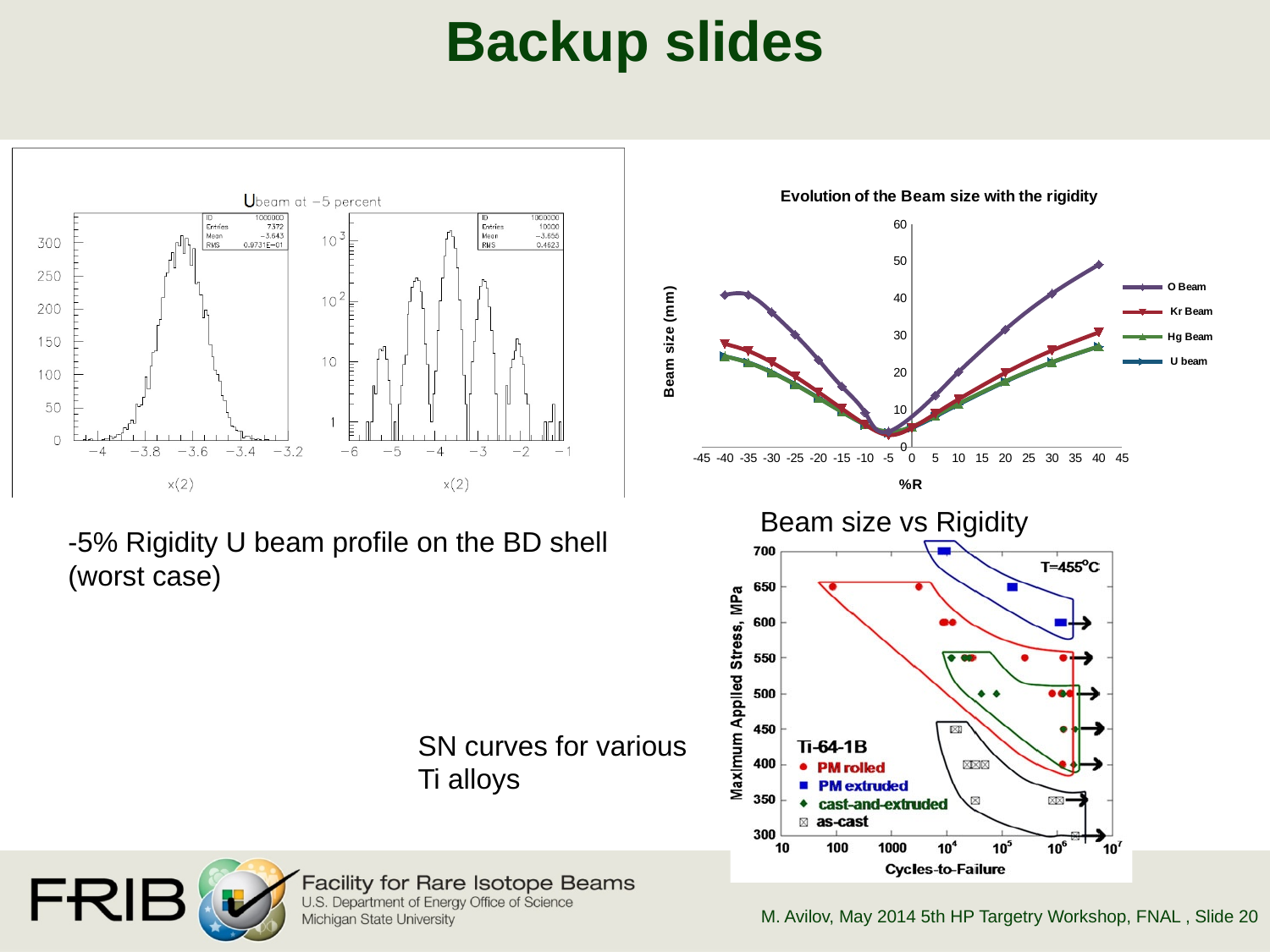
What kind of chart is 'Evolution of the Beam size with the rigidity'? line chart In the 'Evolution of the Beam size with the rigidity' chart, is the Hg Beam value at 40 %R greater or less than 30 mm? less In the 'Evolution of the Beam size with the rigidity' chart, do the beam size values rise or fall as %R goes from 0 to 40? rise In the SN curves chart (bottom right), what is the x-axis label? Cycles-to-Failure In the 'Evolution of the Beam size with the rigidity' chart, how many series does the legend list? 4 In the SN curves chart (bottom right), which series contains the point with the highest maximum applied stress? PM extruded In the SN curves chart (bottom right), how many entries does the legend list? 4 In the 'Evolution of the Beam size with the rigidity' chart, is the O Beam value at 40 %R greater or less than 40 mm? greater In the 'Evolution of the Beam size with the rigidity' chart, which series has the largest beam size at 40 %R? O Beam In the left histogram of the 'U beam at -5 percent' plot, what is the number of entries shown in the statistics box? 7372 What is the y-axis label of the 'Evolution of the Beam size with the rigidity' chart? Beam size (mm)